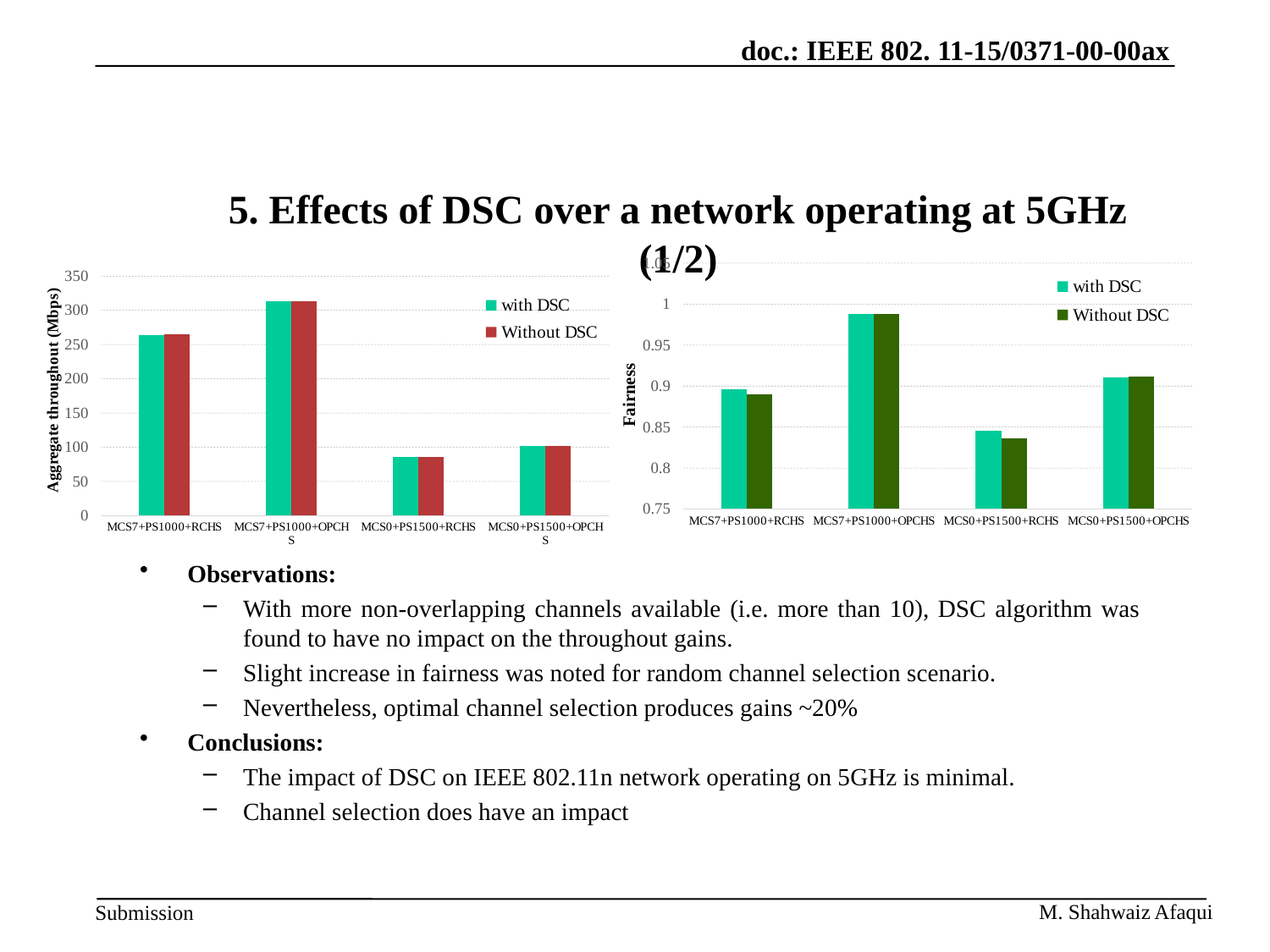
In the left chart (Aggregate throughout), is the 'with DSC' value for MCS0+PS1500+RCHS greater or less than 100? less In the right chart (Fairness), which category has the lowest fairness? MCS0+PS1500+RCHS In the right chart (Fairness), which is larger: the 'with DSC' value for MCS7+PS1000+RCHS or for MCS0+PS1500+OPCHS? MCS0+PS1500+OPCHS What is the y-axis title of the left chart? Aggregate throughout (Mbps) In the left chart (Aggregate throughout), is the 'with DSC' value for MCS7+PS1000+OPCHS greater or less than 300? greater In the right chart (Fairness), which category has the highest fairness? MCS7+PS1000+OPCHS In the left chart (Aggregate throughout), how many categories are shown on the x axis? 4 In the left chart (Aggregate throughout), which category has the highest throughput? MCS7+PS1000+OPCHS In the left chart (Aggregate throughout), what kind of chart is shown? bar chart In the right chart (Fairness), how many series does the legend list? 2 In the left chart (Aggregate throughout), which category has the lowest throughput? MCS0+PS1500+RCHS